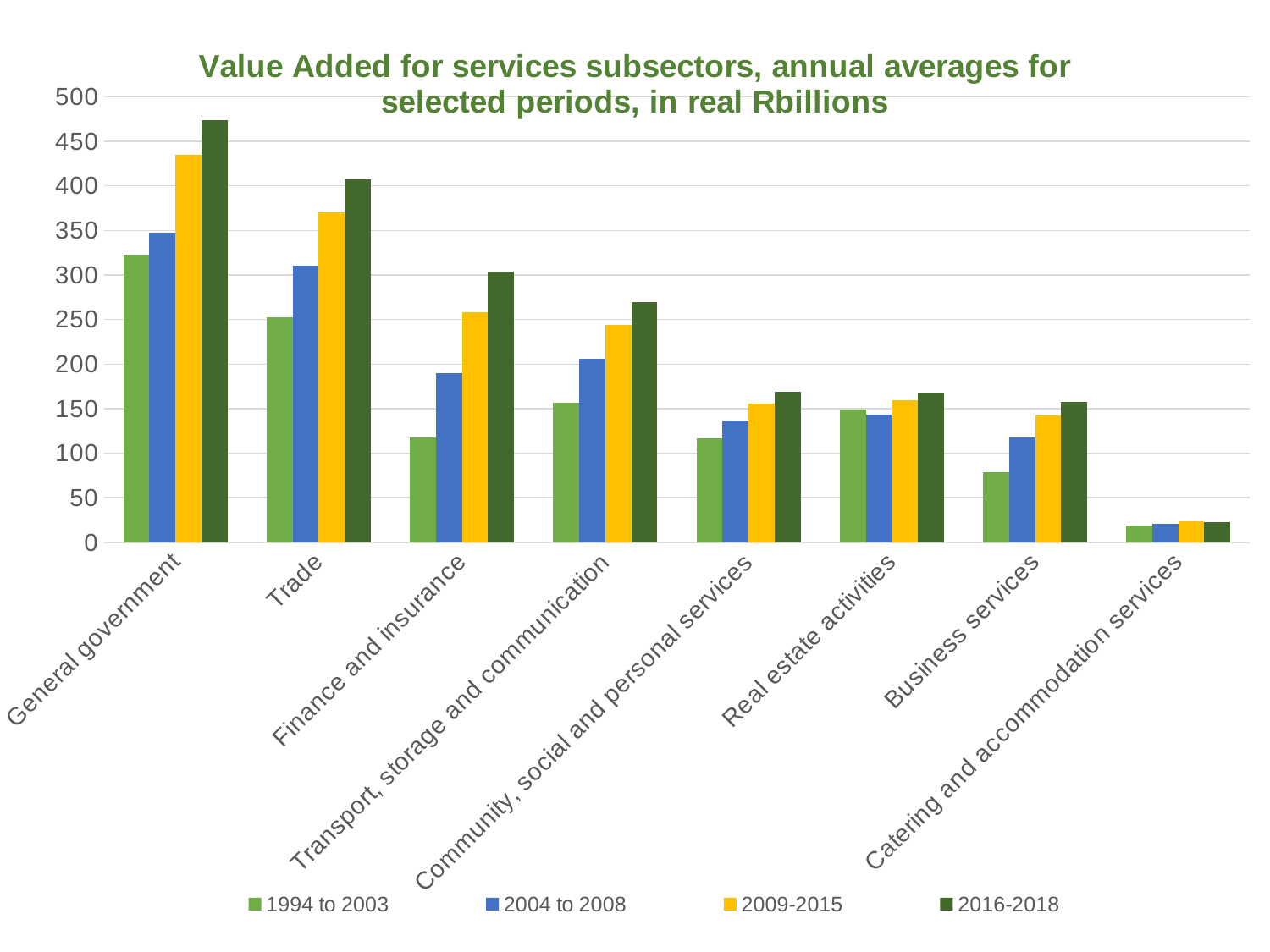
For 2016-2018, which is larger: Finance and insurance or Transport, storage and communication? Finance and insurance How many series does the legend list? 4 Is the value for General government in 2016-2018 greater or less than 450? greater Which subsector has the lowest value for 2016-2018? Catering and accommodation services Is the value for Trade in 2009-2015 greater or less than 350? greater Which subsector has the highest value for 2016-2018? General government How many services subsectors are shown on the x axis? 8 For Business services, do the values rise or fall from 1994 to 2003 through 2016-2018? rise Is the value for Business services in 1994 to 2003 greater or less than 100? less What kind of chart is shown on the slide? Bar chart What is the title of the chart? Value Added for services subsectors, annual averages for selected periods, in real Rbillions